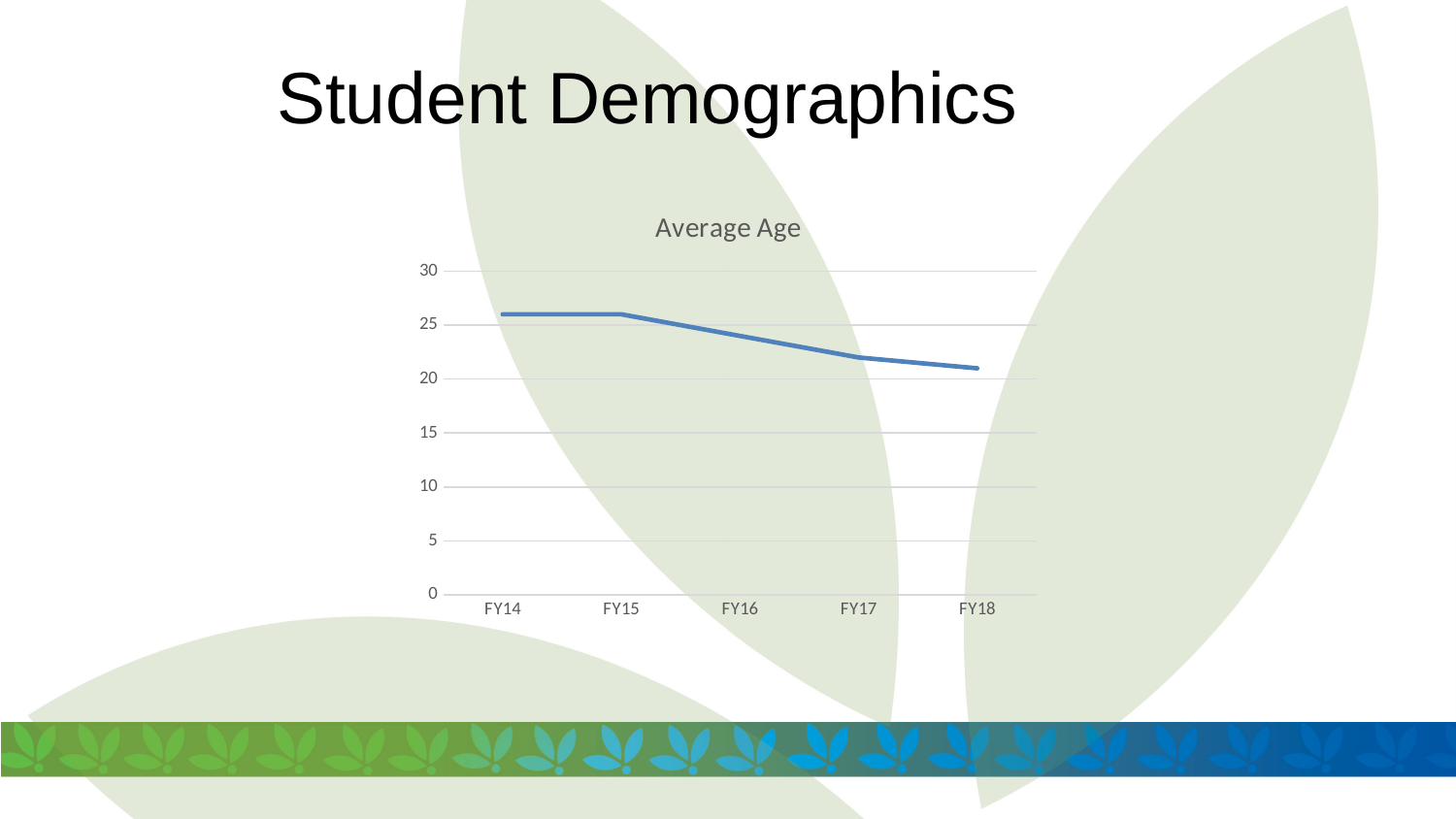
Is the average age for FY17 greater or less than 25? less What is the highest value shown on the y axis of the Average Age chart? 30 Which has the lower average age, FY15 or FY17? FY17 Does the average age rise or fall from FY14 to FY18? fall Is the average age for FY14 greater or less than 30? less Is the average age for FY16 greater or less than 20? greater Which has the higher average age, FY14 or FY18? FY14 What is the title of the chart? Average Age How many fiscal years are plotted on the x axis of the Average Age chart? 5 What kind of chart is shown on the slide? line chart